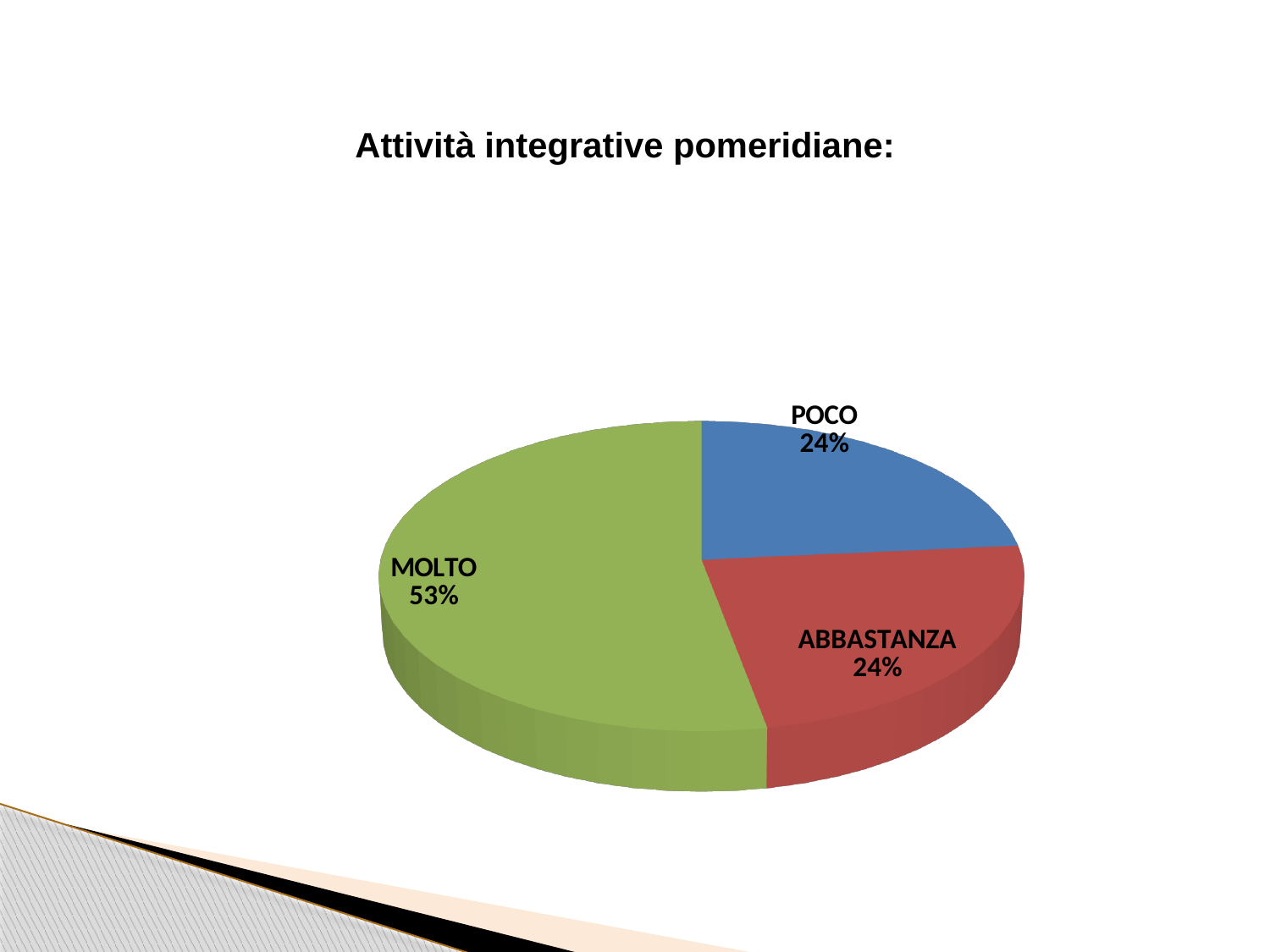
What is the share for ABBASTANZA? 24% What is the share for POCO? 24% How many slices does the pie chart have? 3 What kind of chart is shown on the slide? pie chart What is the title of the chart? Attività integrative pomeridiane: Which category has the largest slice of the pie? MOLTO Which is larger, the share for MOLTO or the share for ABBASTANZA? MOLTO What is the difference in percentage points between MOLTO and POCO? 29 What is the share for MOLTO? 53% What colour is the MOLTO slice? green Is the share for MOLTO greater or less than 50%? greater